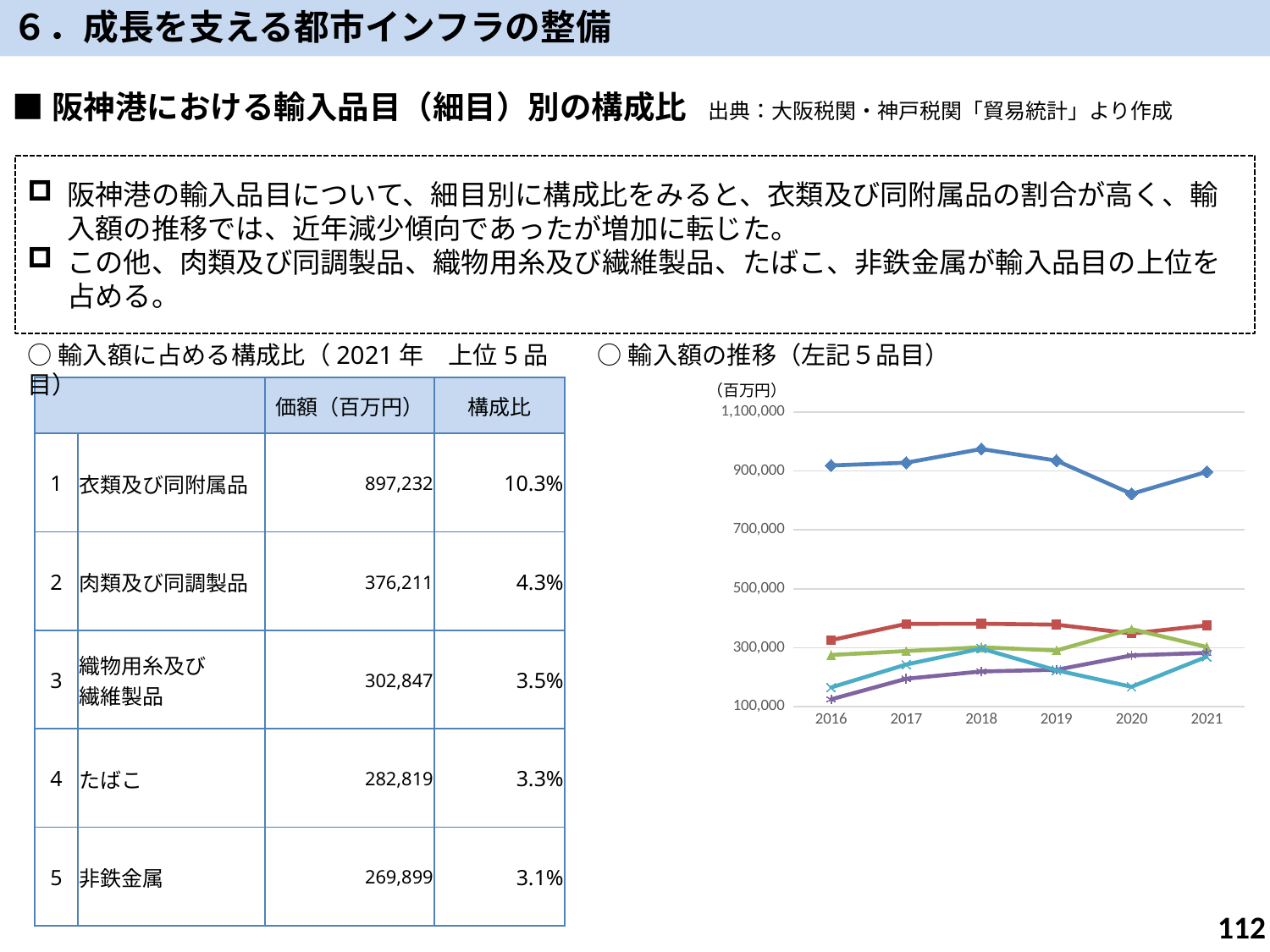
「輸入額の推移（左記５品目）」のグラフで、青い線の2020年の値は900,000より大きいですか、小さいですか？ 小さい 「輸入額の推移（左記５品目）」のグラフはどの種類のグラフですか？ 折れ線グラフ 「輸入額の推移（左記５品目）」のグラフの縦軸の単位は何ですか？ 百万円 「輸入額の推移（左記５品目）」のグラフには何本の折れ線が描かれていますか？ 5 「輸入額の推移（左記５品目）」のグラフで、全期間を通じて最も高い位置にある折れ線は何色ですか？ 青 「輸入額の推移（左記５品目）」のグラフで、紫の線の2016年の値は300,000より大きいですか、小さいですか？ 小さい 「輸入額の推移（左記５品目）」のグラフで、赤い線の値は2016年と2017年のどちらが大きいですか？ 2017年 「輸入額の推移（左記５品目）」のグラフの横軸には何年分のデータ点がありますか？ 6 「輸入額の推移（左記５品目）」のグラフで、青い線の値は2020年と2021年のどちらが大きいですか？ 2021年 「輸入額の推移（左記５品目）」のグラフで、青い線は2018年から2020年にかけて上昇していますか、下降していますか？ 下降 「輸入額の推移（左記５品目）」のグラフで、赤い線の2017年の値は300,000より大きいですか、小さいですか？ 大きい